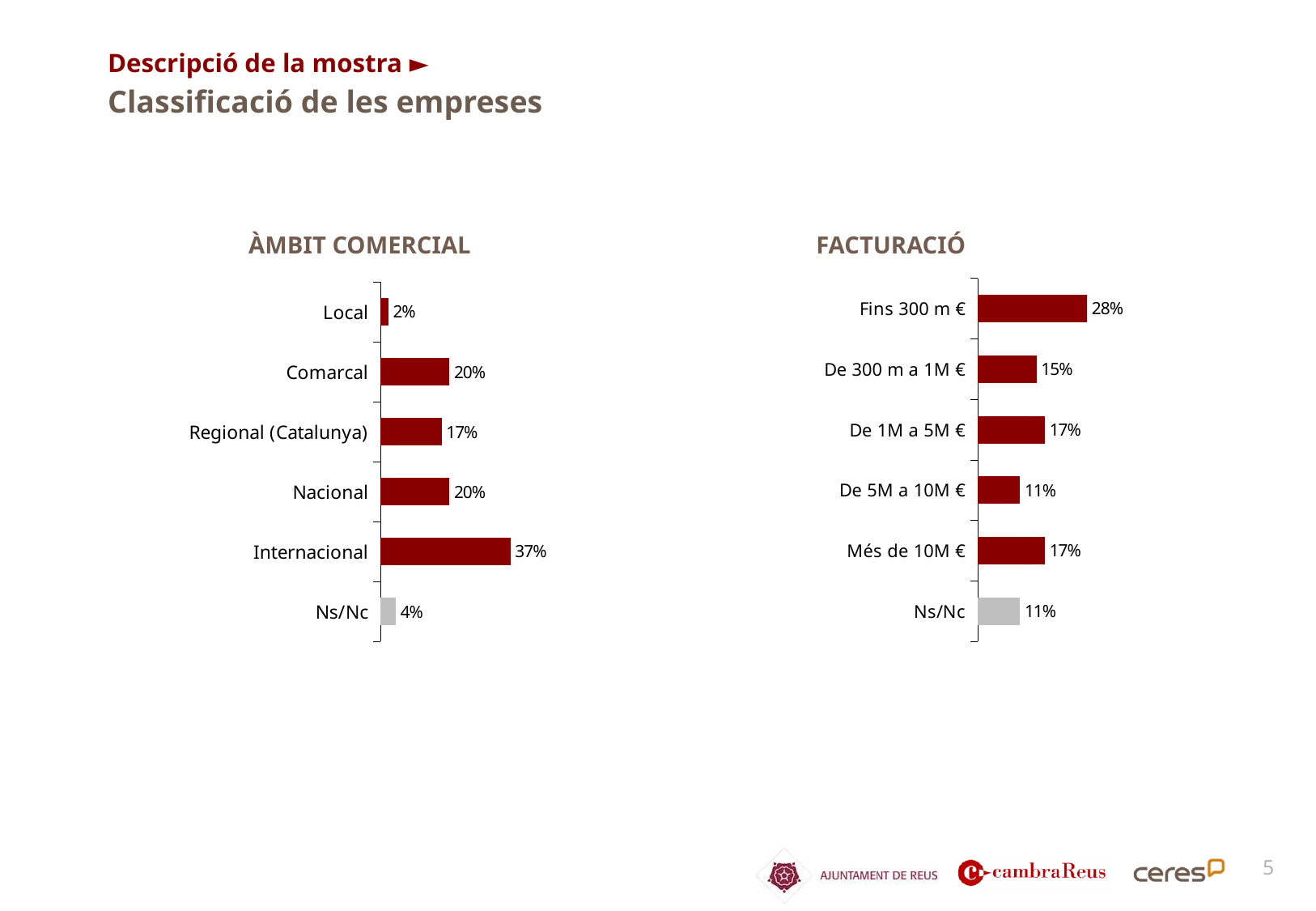
In the ÀMBIT COMERCIAL chart, what is the difference between Internacional and Comarcal? 17% In the ÀMBIT COMERCIAL chart, what is the value for Internacional? 37% In the FACTURACIÓ chart, which is larger, De 300 m a 1M € or De 1M a 5M €? De 1M a 5M € In the ÀMBIT COMERCIAL chart, how many categories are shown? 6 What kind of chart is the FACTURACIÓ chart? Bar chart In the ÀMBIT COMERCIAL chart, what is the value for Local? 2% In the ÀMBIT COMERCIAL chart, which category has the highest value? Internacional In the ÀMBIT COMERCIAL chart, which category has the lowest value? Local In the FACTURACIÓ chart, which category has the highest value? Fins 300 m € In the FACTURACIÓ chart, what is the difference between Fins 300 m € and Ns/Nc? 17% In the FACTURACIÓ chart, what is the value for Fins 300 m €? 28% In the FACTURACIÓ chart, what is the value for De 5M a 10M €? 11%